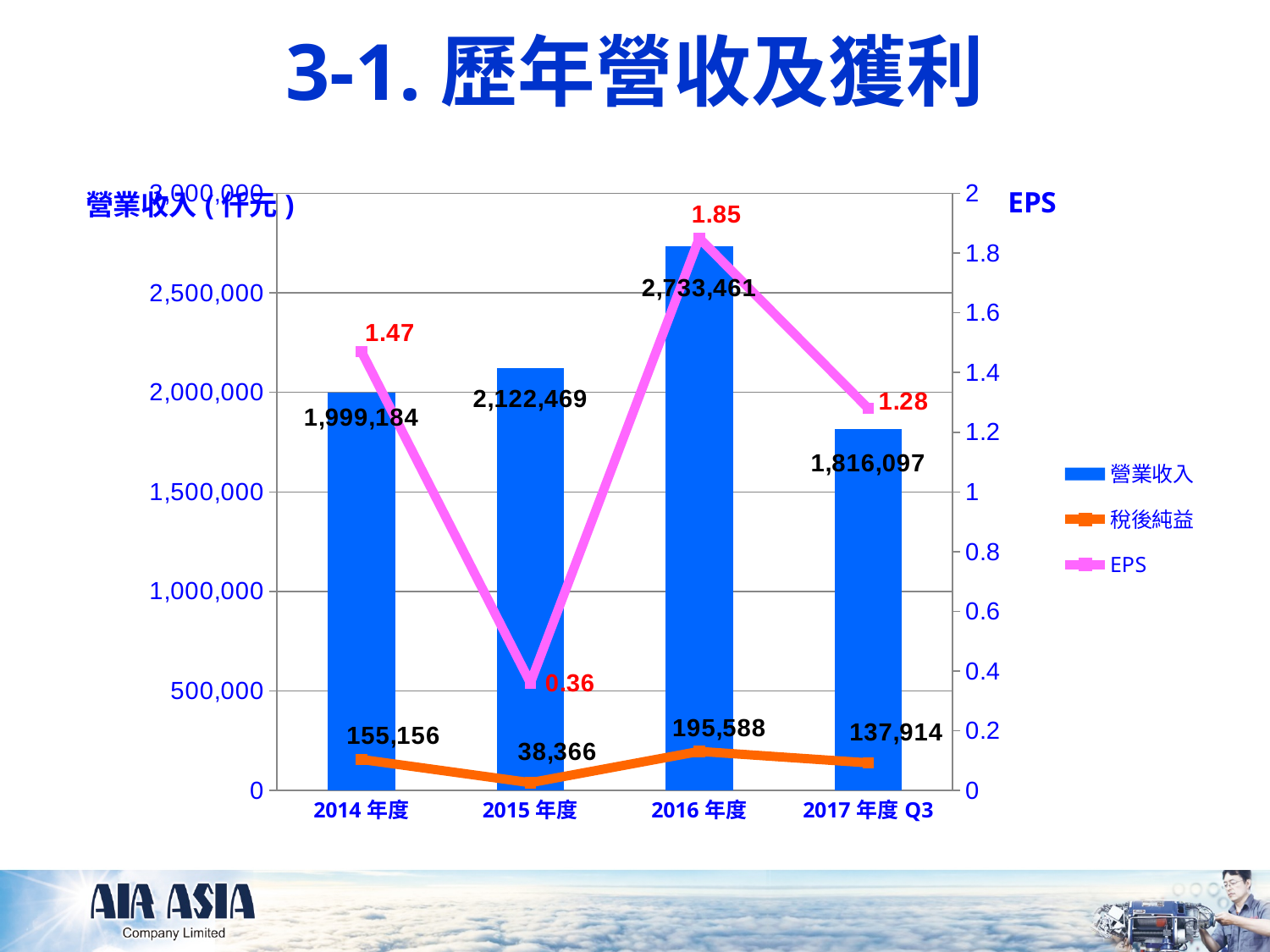
Which series is drawn in orange? 稅後純益 What is the 稅後純益 value for 2015 年度? 38,366 How many periods are shown on the x axis? 4 What is the EPS value for 2017 年度 Q3? 1.28 What is the difference in EPS between 2016 年度 and 2014 年度? 0.38 Which year has the highest 營業收入? 2016 年度 How many series does the legend list? 3 What kind of chart is used to show 營業收入? bar chart Which year has the lowest EPS? 2015 年度 What is the 營業收入 value for 2016 年度? 2,733,461 Which is larger, the 稅後純益 for 2014 年度 or for 2017 年度 Q3? 2014 年度 What is the difference in 營業收入 between 2016 年度 and 2017 年度 Q3? 917,364